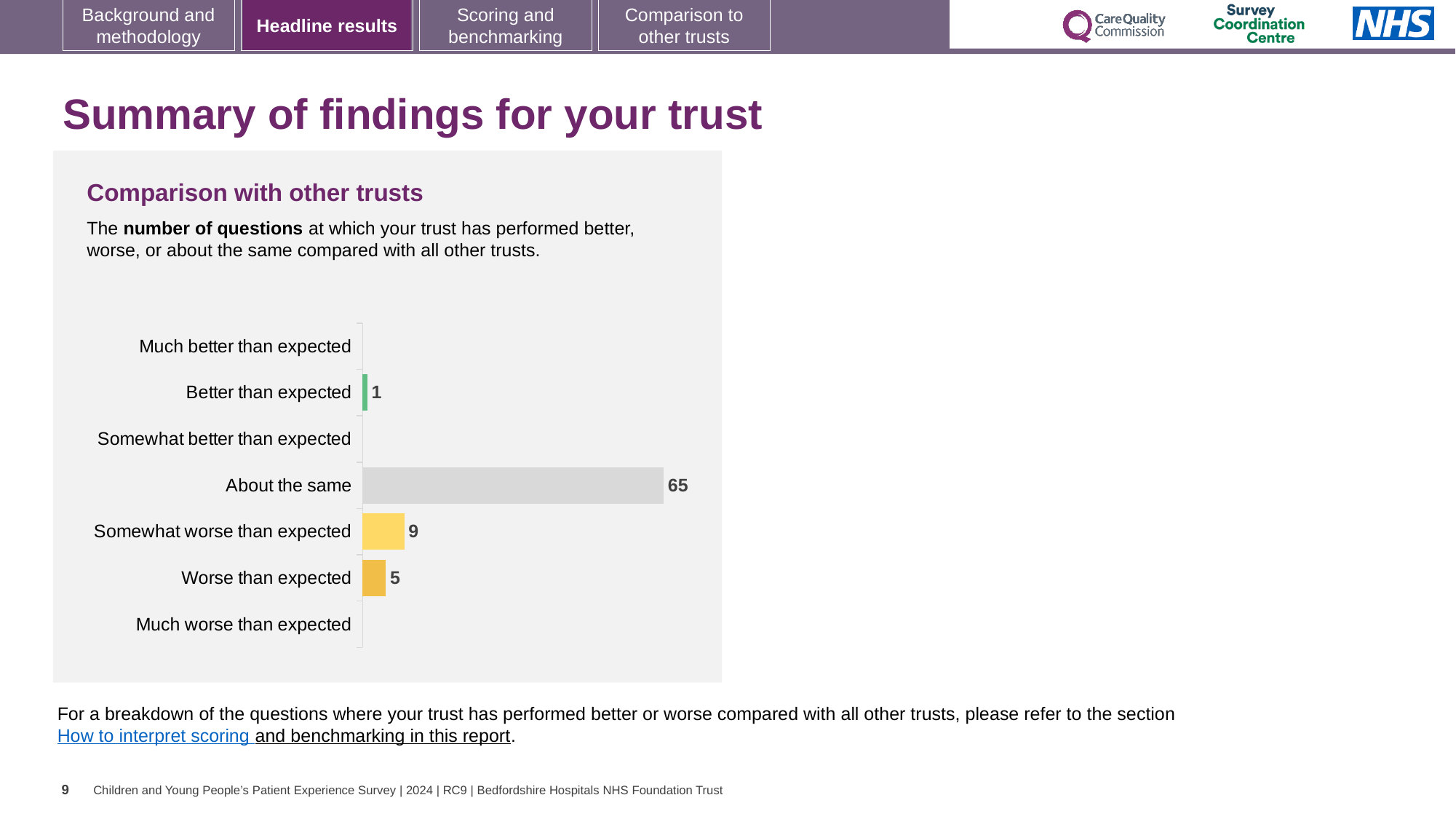
What is the value for 'Somewhat worse than expected'? 9 What is the title of the chart section on the slide? Comparison with other trusts How many questions are in the 'About the same' category? 65 What is the difference between 'Somewhat worse than expected' and 'Worse than expected'? 4 Which is larger: 'Somewhat worse than expected' or 'Worse than expected'? Somewhat worse than expected What is the difference between the 'About the same' value and the 'Somewhat worse than expected' value? 56 What type of chart is shown on the slide? Bar chart How many categories are listed on the chart's vertical axis? 7 What is the combined number of questions in the 'Somewhat worse than expected' and 'Worse than expected' categories? 14 Which category has the highest number of questions? About the same What is the value for 'Better than expected'? 1 What is the value for 'Worse than expected'? 5